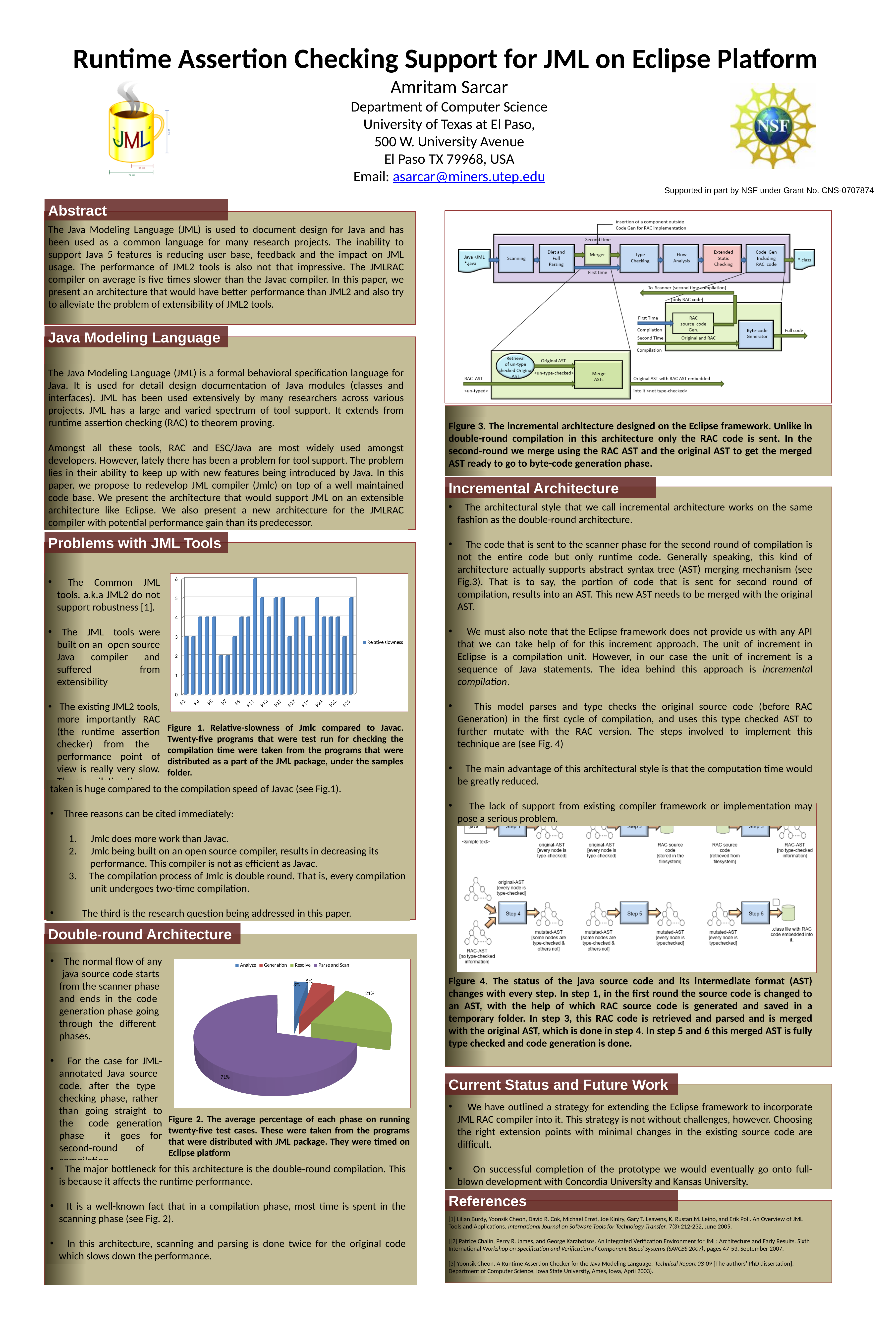
In the bar chart in Figure 1, how many series does the legend list? 1 In the pie chart in Figure 2, what percentage is shown for Resolve? 21% In the bar chart in Figure 1, is the value for P11 greater or less than 5? greater In the pie chart in Figure 2, how many categories does the legend list? 4 What kind of chart is Figure 1? bar chart In the bar chart in Figure 1, what is the relative slowness value for P11? 6 In the pie chart in Figure 2, what percentage is shown for Parse and Scan? 71% In the bar chart in Figure 1, is the value for P7 greater or less than 3? less In the bar chart in Figure 1, what is the highest value reached by any bar? 6 In the bar chart in Figure 1, which program has the highest relative slowness? P11 In the bar chart in Figure 1, which is larger, the value for P11 or the value for P1? P11 In the pie chart in Figure 2, which phase has the smallest share? Analyze